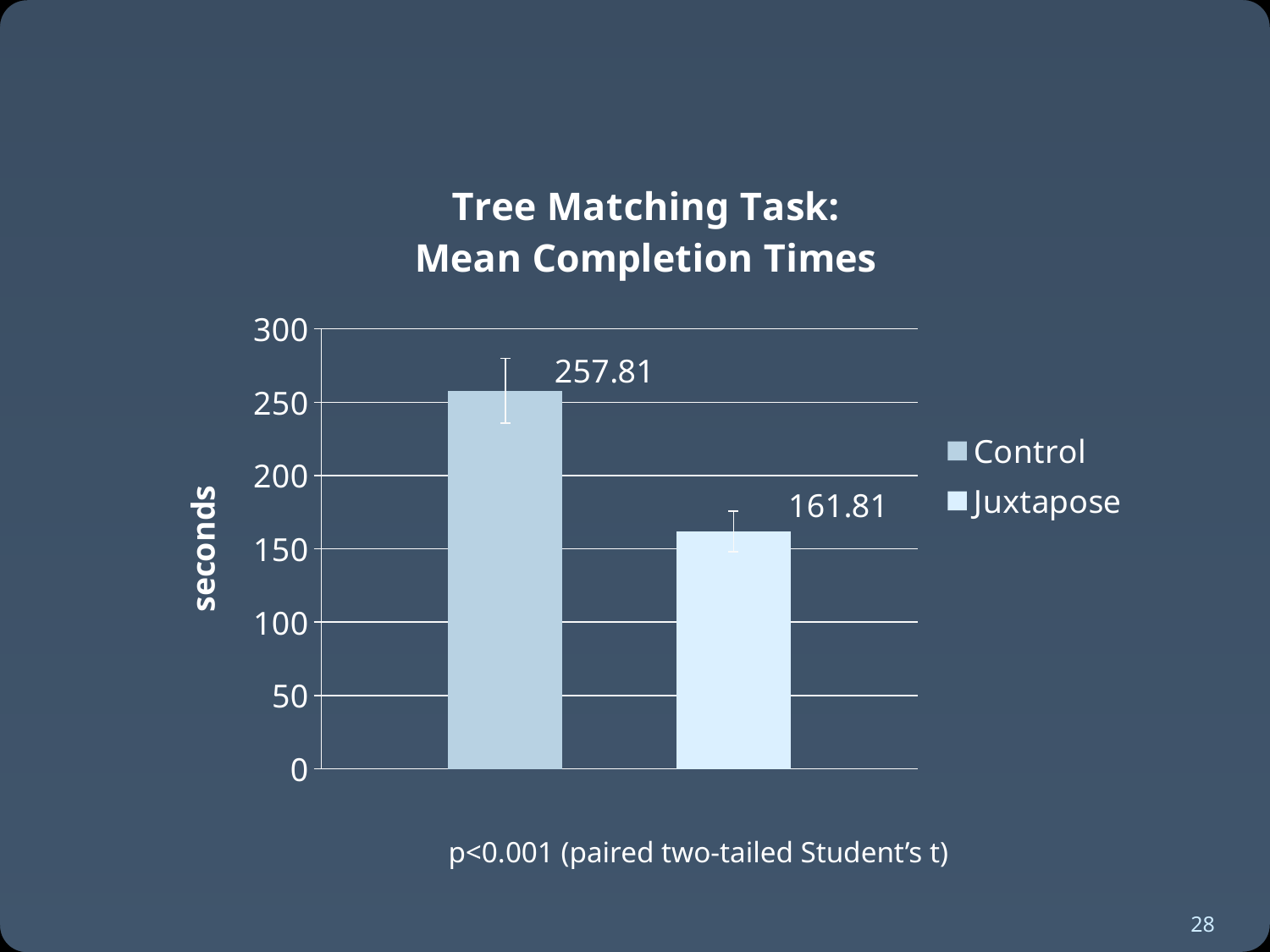
How many bars are plotted in the chart? 2 How many series does the legend list? 2 What is the mean completion time for Juxtapose? 161.81 Is the value for Juxtapose greater or less than 200? less What kind of chart is shown on the slide? bar chart Which condition has the lower mean completion time? Juxtapose Is the value for Control greater or less than 250? greater What is the difference between the Control and Juxtapose mean completion times? 96 What is the label on the vertical axis? seconds Which condition has the higher mean completion time? Control What is the mean completion time for Control? 257.81 Is the mean completion time for Control larger or smaller than for Juxtapose? larger